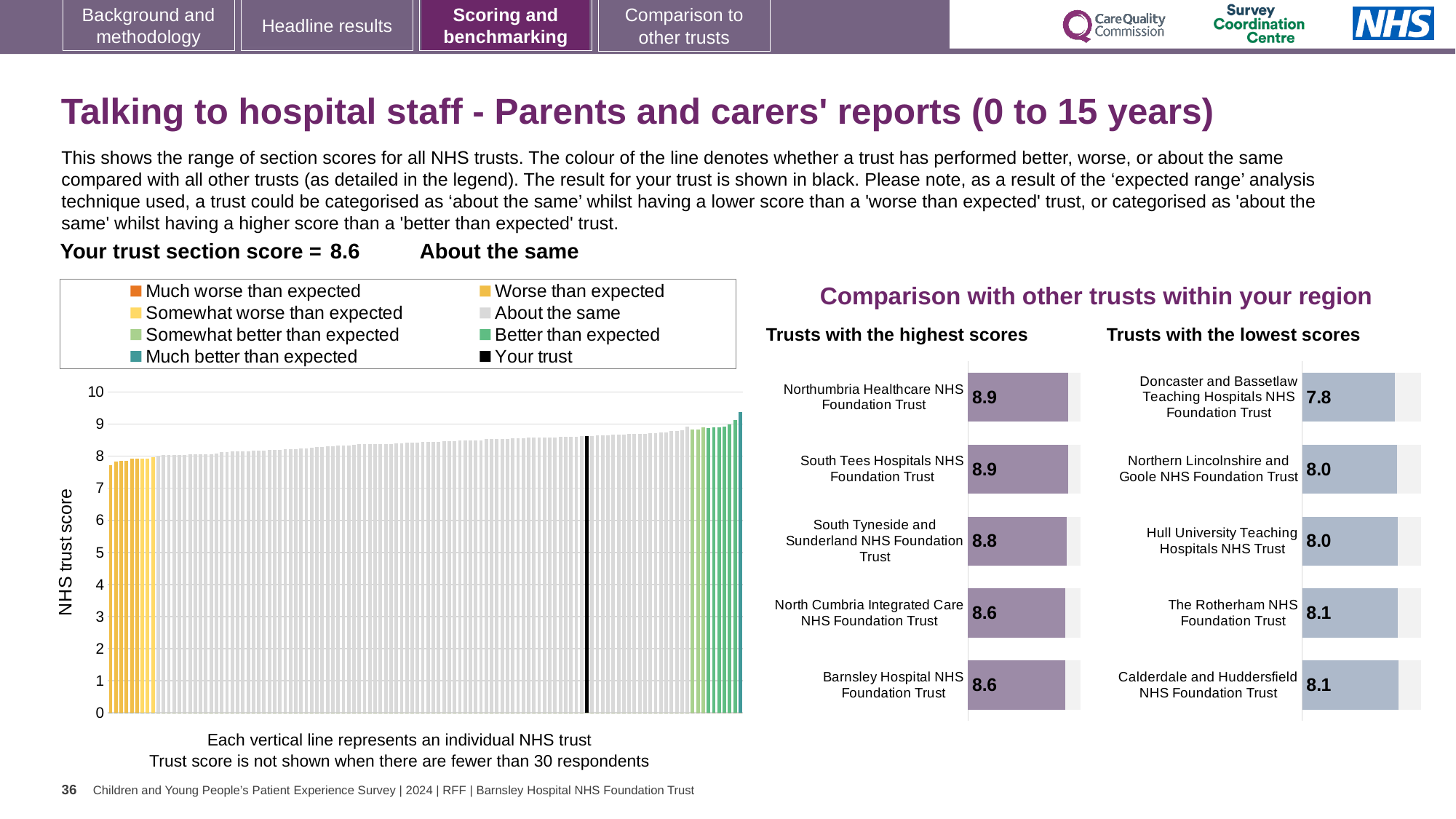
What is the y-axis label of the main chart on the left? NHS trust score In the main chart on the left, do the trust scores rise or fall from left to right along the x axis? rise How many trusts are shown in the 'Trusts with the highest scores' chart? 5 In the 'Trusts with the lowest scores' chart, what is the score for Doncaster and Bassetlaw Teaching Hospitals NHS Foundation Trust? 7.8 In the 'Trusts with the lowest scores' chart, what is the difference between the scores of Calderdale and Huddersfield NHS Foundation Trust and Doncaster and Bassetlaw Teaching Hospitals NHS Foundation Trust? 0.3 In the 'Trusts with the lowest scores' chart, which trust has the lowest score? Doncaster and Bassetlaw Teaching Hospitals NHS Foundation Trust In the 'Trusts with the lowest scores' chart, which has the higher score: Hull University Teaching Hospitals NHS Trust or The Rotherham NHS Foundation Trust? The Rotherham NHS Foundation Trust What kind of chart is the main chart on the left showing all NHS trusts? bar chart In the 'Trusts with the highest scores' chart, what is the difference between the scores of Northumbria Healthcare NHS Foundation Trust and Barnsley Hospital NHS Foundation Trust? 0.3 How many entries does the legend of the main chart on the left list? 8 In the main chart on the left, what is the section score for your trust (shown in black)? 8.6 In the 'Trusts with the highest scores' chart, what is the score for South Tyneside and Sunderland NHS Foundation Trust? 8.8